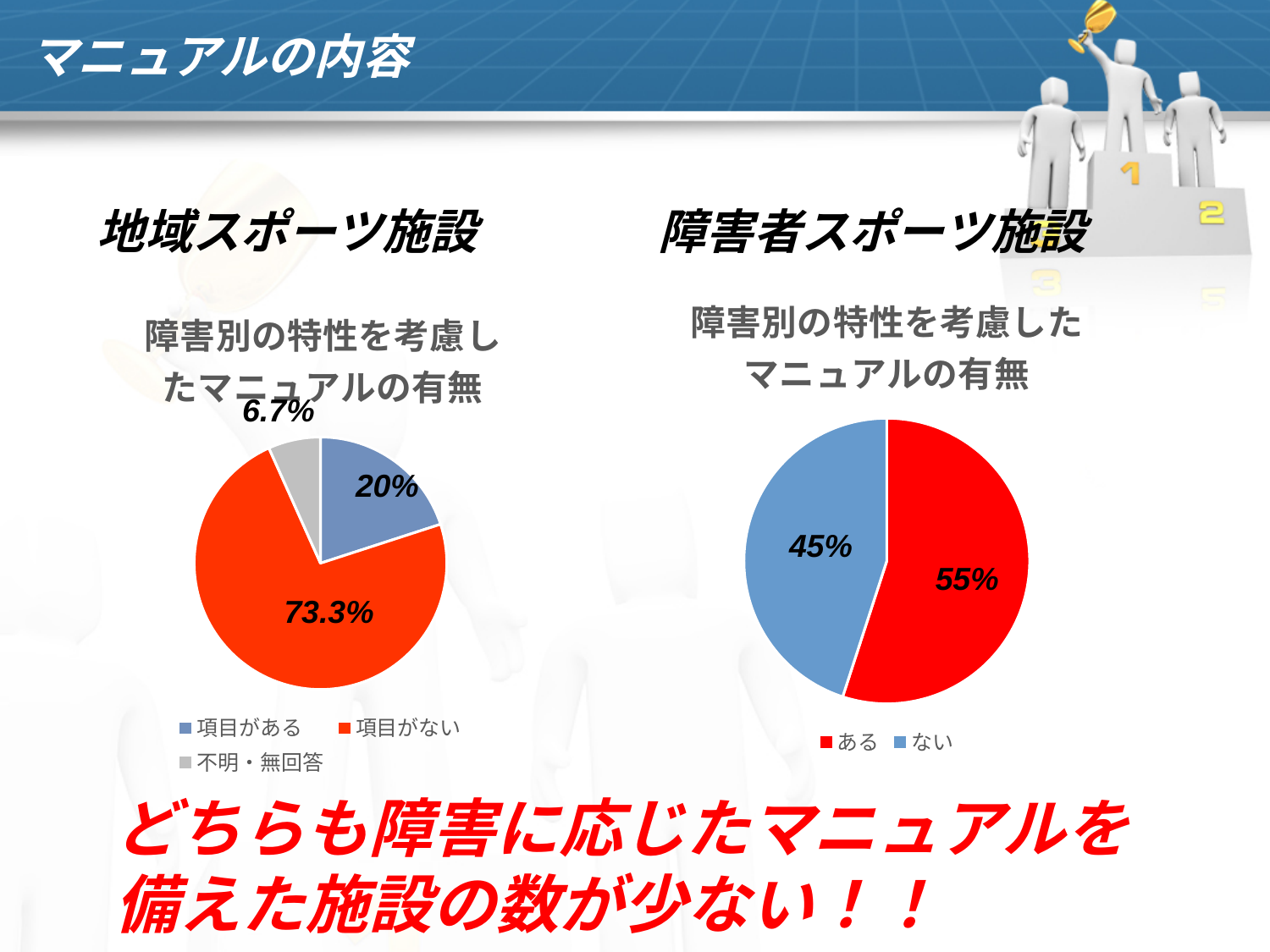
In the right pie chart (障害者スポーツ施設), what colour is the slice for ある? Red In the right pie chart (障害者スポーツ施設), what is the difference between the shares for ある and ない? 10% In the left pie chart (地域スポーツ施設), what is the share for 項目がある? 20% In the left pie chart (地域スポーツ施設), how many categories does the legend list? 3 In the left pie chart (地域スポーツ施設), what is the share for 項目がない? 73.3% In the right pie chart (障害者スポーツ施設), what is the share for ない? 45% In the left pie chart (地域スポーツ施設), which category has the smallest share? 不明・無回答 What kind of chart is used on the left side of the slide (地域スポーツ施設)? Pie chart In the right pie chart (障害者スポーツ施設), what is the share for ある? 55% In the right pie chart (障害者スポーツ施設), which is larger, ある or ない? ある In the left pie chart (地域スポーツ施設), what is the share for 不明・無回答? 6.7% In the left pie chart (地域スポーツ施設), which category has the largest share? 項目がない